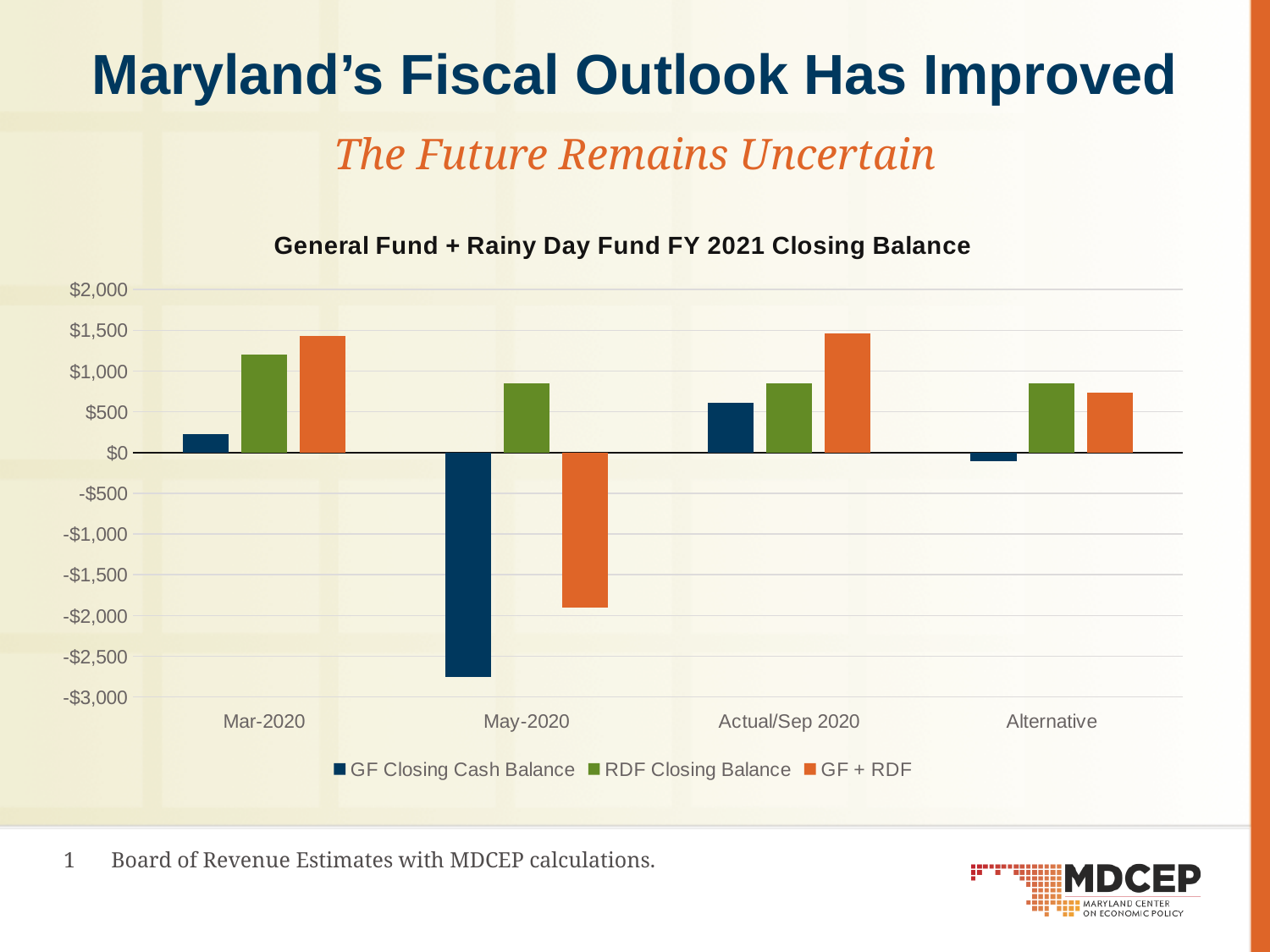
Which is larger, the GF Closing Cash Balance for Actual/Sep 2020 or for Mar-2020? Actual/Sep 2020 How many categories are shown on the x axis? 4 Is the RDF Closing Balance for Mar-2020 greater or less than $1,000? greater Which category has the highest RDF Closing Balance? Mar-2020 Which category has the lowest GF Closing Cash Balance? May-2020 What is the title of the chart? General Fund + Rainy Day Fund FY 2021 Closing Balance Is the GF Closing Cash Balance for May-2020 greater or less than -$2,500? less Is the GF + RDF value for Alternative greater or less than $1,000? less What kind of chart is shown on the slide? bar chart Which is larger, the GF + RDF value for Mar-2020 or for Alternative? Mar-2020 How many series does the legend list? 3